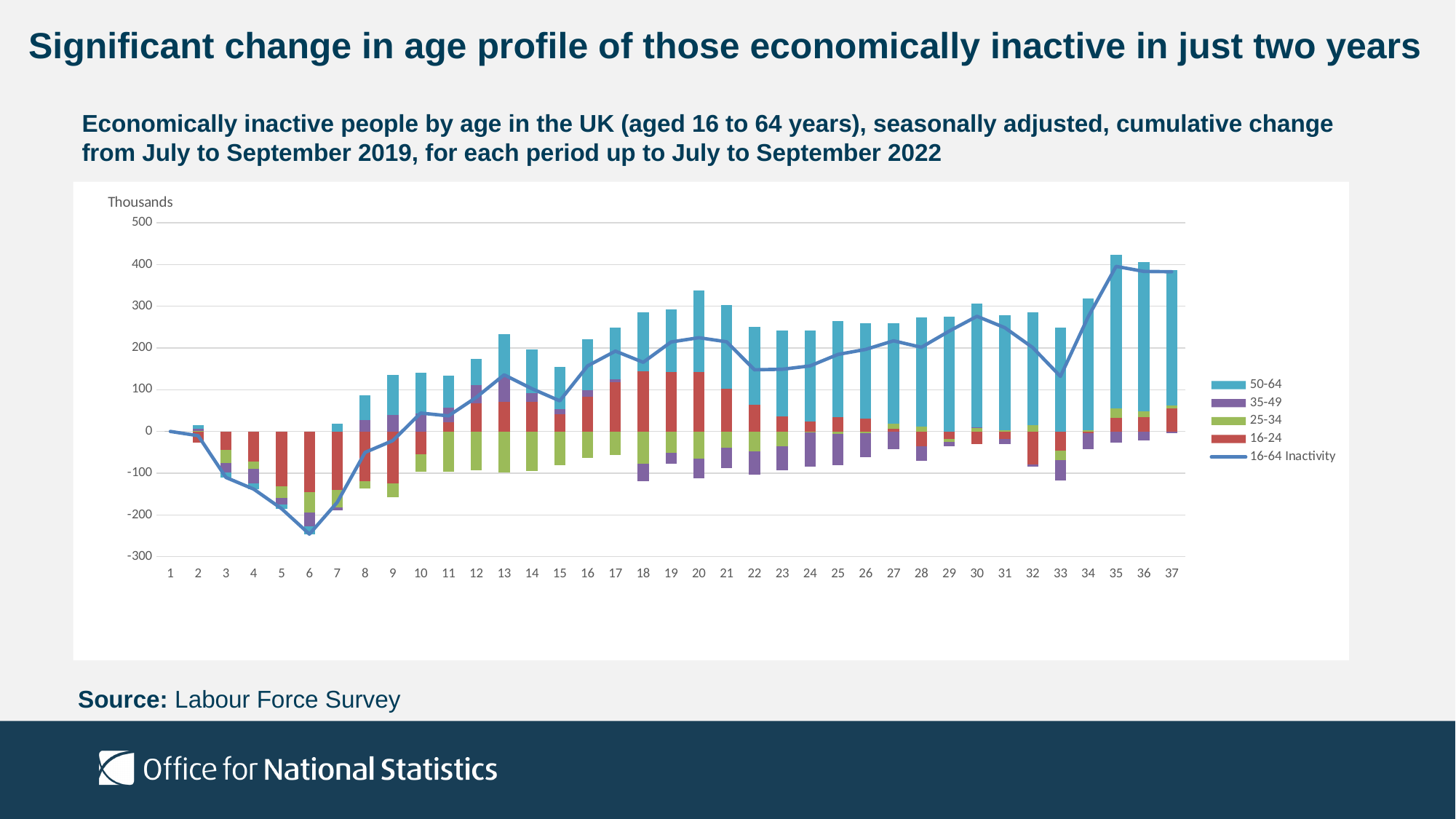
How many periods are plotted along the x axis? 37 What unit is shown on the y axis? Thousands Does the 16-64 Inactivity line overall rise or fall from period 1 to period 37? Rise Is the value of the 16-64 Inactivity line at period 35 greater or less than 300? greater How many series does the legend list? 5 Is the top of the 50-64 bar at period 35 greater or less than 400? greater Is the value of the 16-64 Inactivity line at period 33 greater or less than 200? less What kind of chart is shown on the slide? A stacked bar chart with a line overlay Which is larger, the 16-64 Inactivity line value at period 20 or at period 33? Period 20 Which series is shown as a line rather than bars? 16-64 Inactivity At which period does the 16-64 Inactivity line reach its lowest point? 6